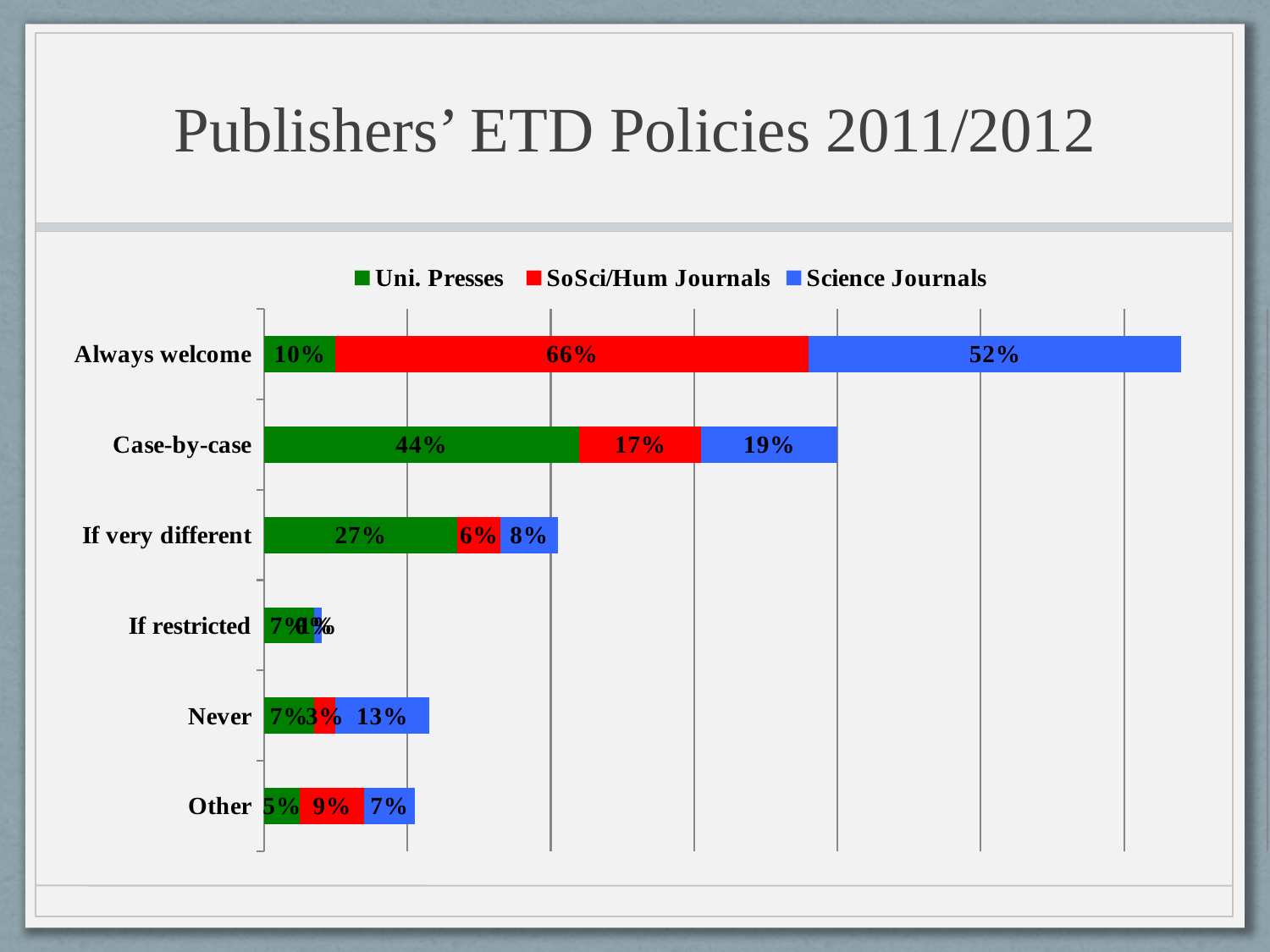
Which is larger in the Case-by-case category: SoSci/Hum Journals or Science Journals? Science Journals Which category has the highest value for Uni. Presses? Case-by-case What is the value for Science Journals in the Never category? 13% What is the value for SoSci/Hum Journals in the Always welcome category? 66% How many series does the legend list? 3 What is the value for Uni. Presses in the Case-by-case category? 44% What is the total of the stacked bar for If very different? 41% What is the value for SoSci/Hum Journals in the Other category? 9% Which category has the highest value for Science Journals? Always welcome How many categories are shown on the chart? 6 What is the difference between the SoSci/Hum Journals and Science Journals values in the Always welcome category? 14% What kind of chart is shown on the slide? Stacked bar chart